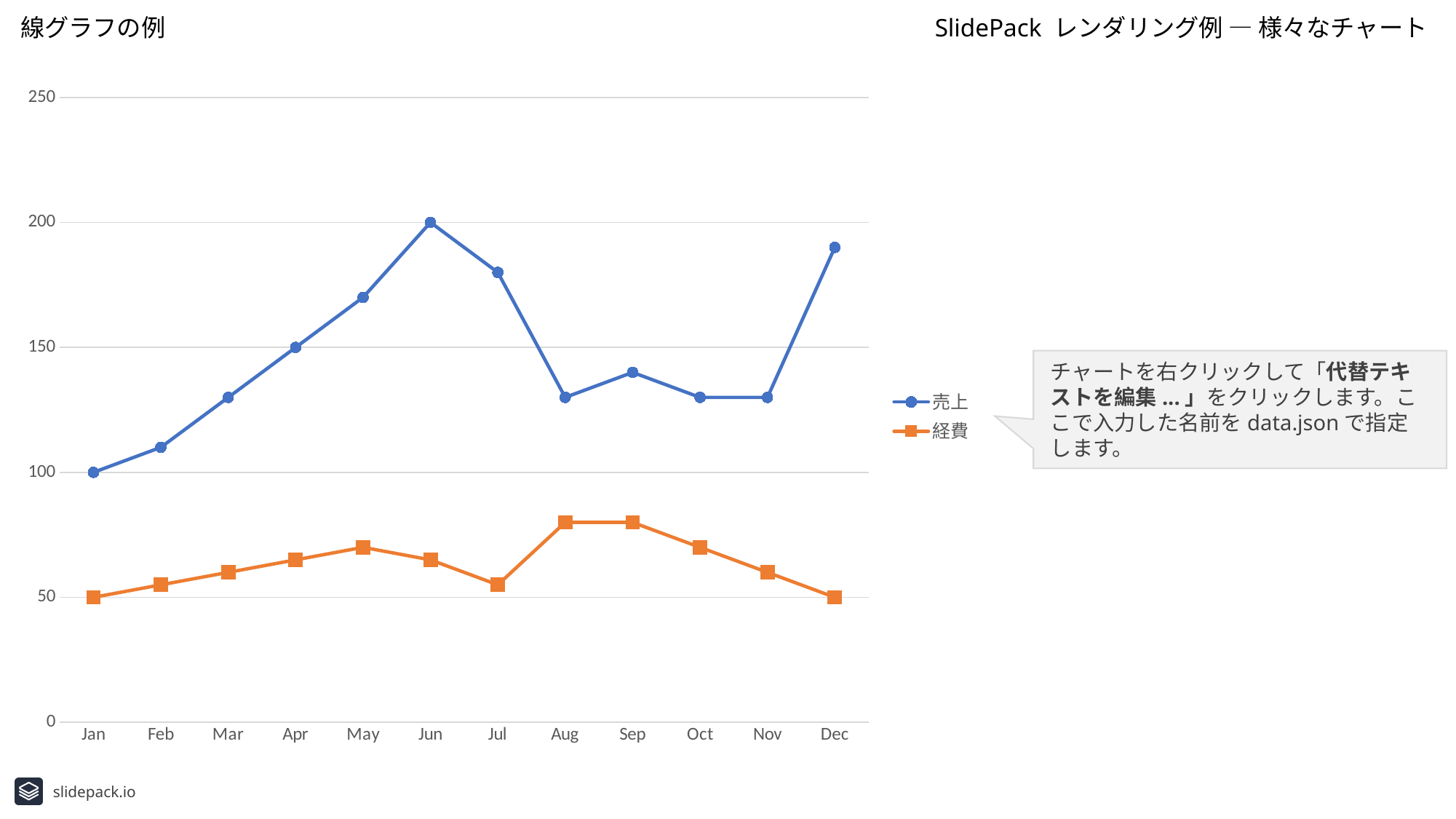
What is the value of 売上 in Jun? 200 Which series has the larger value in Oct, 売上 or 経費? 売上 In which month is 売上 highest? Jun In which month is 売上 lowest? Jan Is the value for 経費 in Aug greater or less than 100? less Is the value for 売上 in Dec greater or less than 150? greater How many series does the legend list? 2 What is the value of 売上 in Jan? 100 How many months are plotted along the x axis? 12 What is the value of 経費 in Jan? 50 Does 売上 rise or fall from Jan to Jun? rise What kind of chart is shown on the slide? line chart